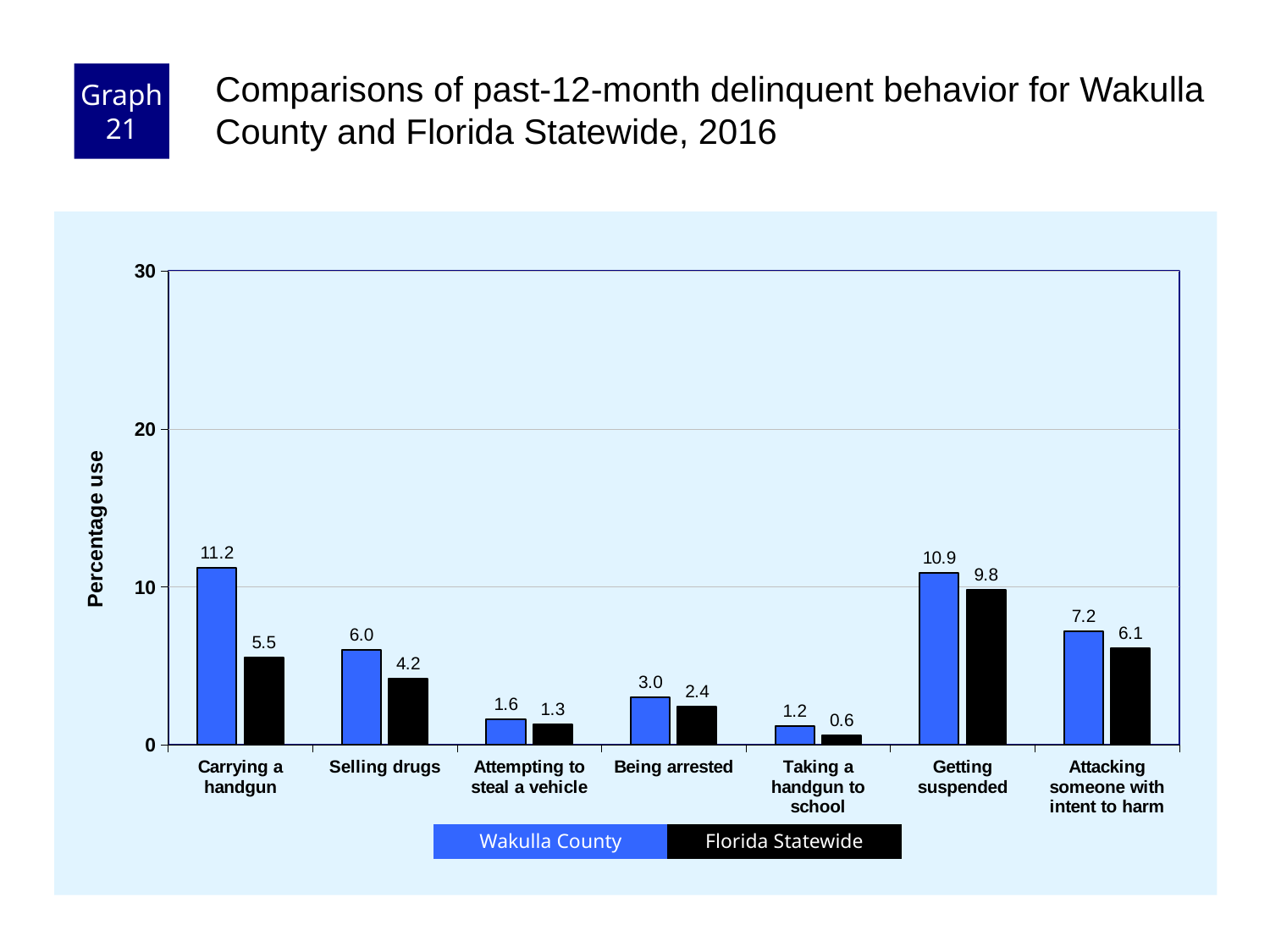
How many series does the legend list? 2 Which is larger for Attacking someone with intent to harm: Wakulla County or Florida Statewide? Wakulla County What is the Wakulla County value for Taking a handgun to school? 1.2 Is the Wakulla County value for Getting suspended greater or less than 10? greater What is the difference between the Wakulla County and Florida Statewide values for Carrying a handgun? 5.7 What kind of chart is shown on the slide? Bar chart What is the difference between the Wakulla County and Florida Statewide values for Selling drugs? 1.8 Which category has the lowest Florida Statewide value? Taking a handgun to school Which category has the highest Wakulla County value? Carrying a handgun What is the Wakulla County value for Carrying a handgun? 11.2 How many categories are shown on the x axis? 7 What is the Florida Statewide value for Getting suspended? 9.8